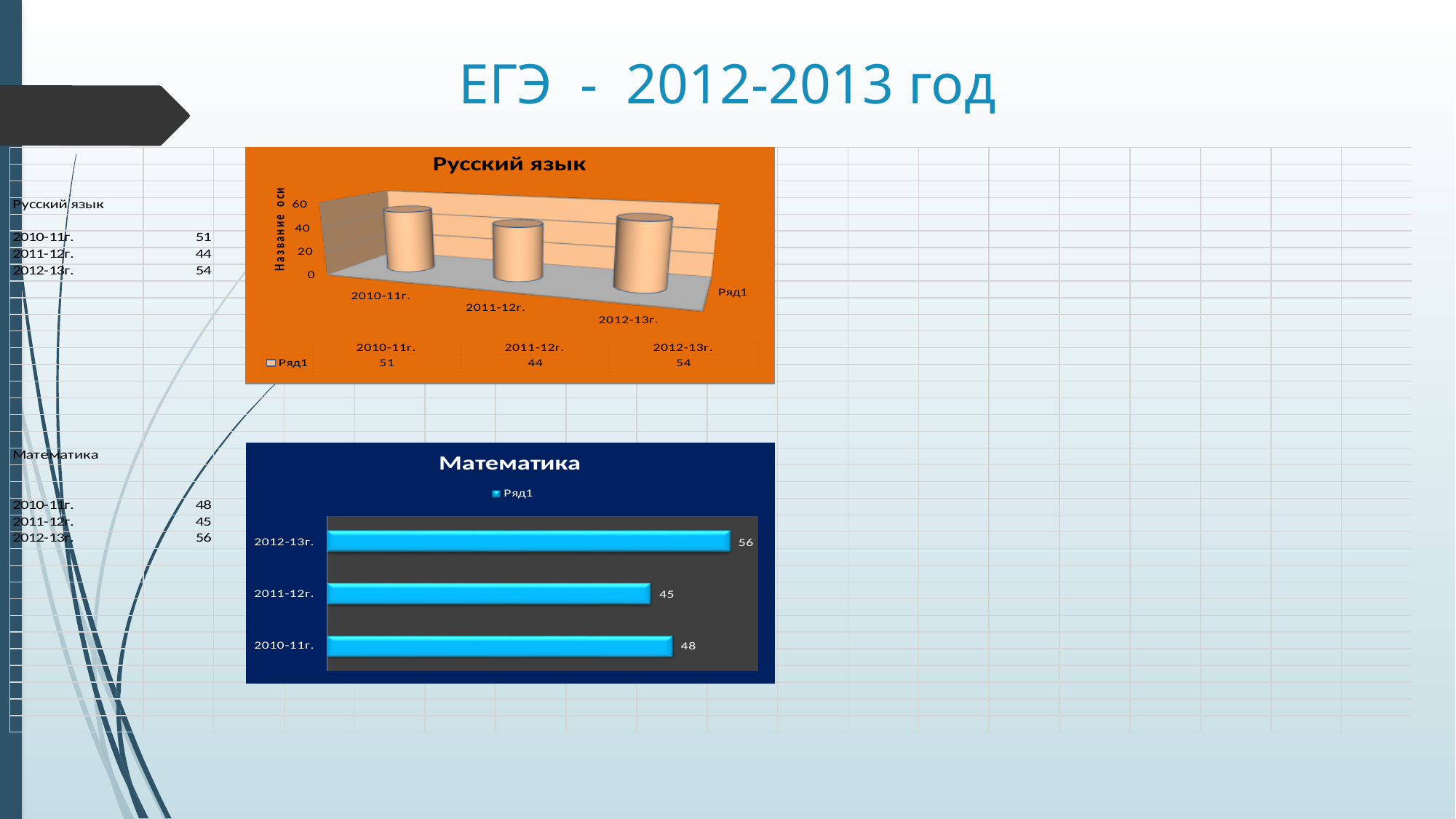
In the 'Русский язык' chart, what is the value for 2012-13г.? 54 In the 'Математика' chart, which year has the lowest value? 2011-12г. In the 'Математика' chart, which is larger: the value for 2010-11г. or 2011-12г.? 2010-11г. In the 'Русский язык' chart, how many categories are shown? 3 In the 'Математика' chart, what is the value for 2010-11г.? 48 In the 'Русский язык' chart, which year has the highest value? 2012-13г. In the 'Русский язык' chart, what is the value for 2011-12г.? 44 In the 'Математика' chart, what is the difference between the values for 2012-13г. and 2011-12г.? 11 In the 'Русский язык' chart, which year has the lowest value? 2011-12г. In the 'Математика' chart, what is the value for 2012-13г.? 56 What kind of chart is the 'Математика' chart? bar chart In the 'Русский язык' chart, what is the difference between the values for 2012-13г. and 2010-11г.? 3